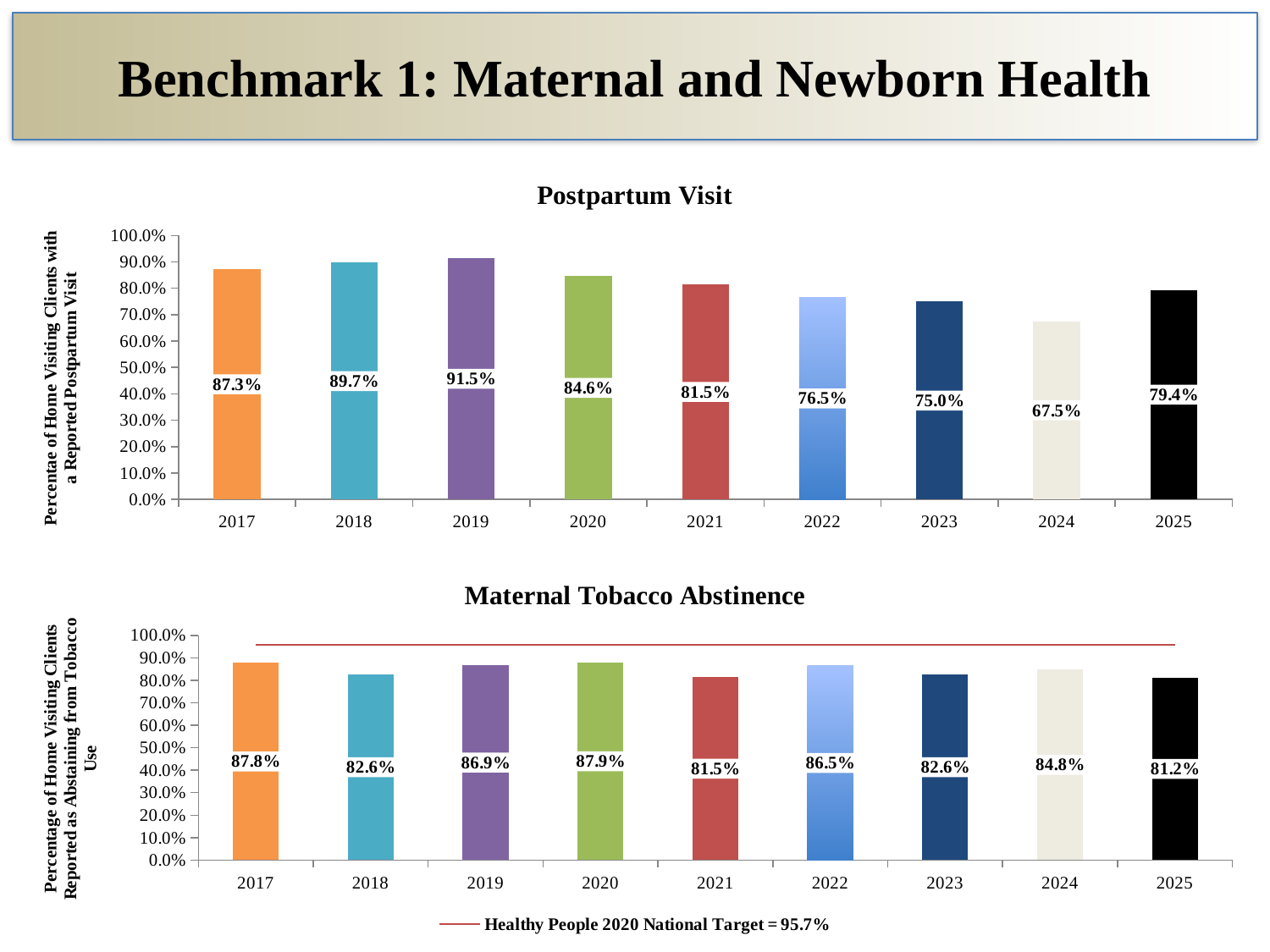
How many years are shown on the x axis of the Postpartum Visit chart? 9 In the Maternal Tobacco Abstinence chart, what is the difference between the 2017 and 2018 values? 5.2% In the Maternal Tobacco Abstinence chart, which is larger, the value for 2019 or the value for 2023? 2019 In the Postpartum Visit chart, which year has the lowest value? 2024 In the Postpartum Visit chart, what is the difference between the 2018 and 2024 values? 22.2% In the Maternal Tobacco Abstinence chart, what is the value for 2021? 81.5% In the Postpartum Visit chart, which is larger, the value for 2022 or the value for 2025? 2025 In the Maternal Tobacco Abstinence chart, what is the value for 2024? 84.8% In the Postpartum Visit chart, which year has the highest value? 2019 What kind of chart is the Postpartum Visit chart? Bar chart In the Postpartum Visit chart, what is the value for 2019? 91.5% What target value does the horizontal line in the Maternal Tobacco Abstinence chart represent, according to the legend? Healthy People 2020 National Target = 95.7%